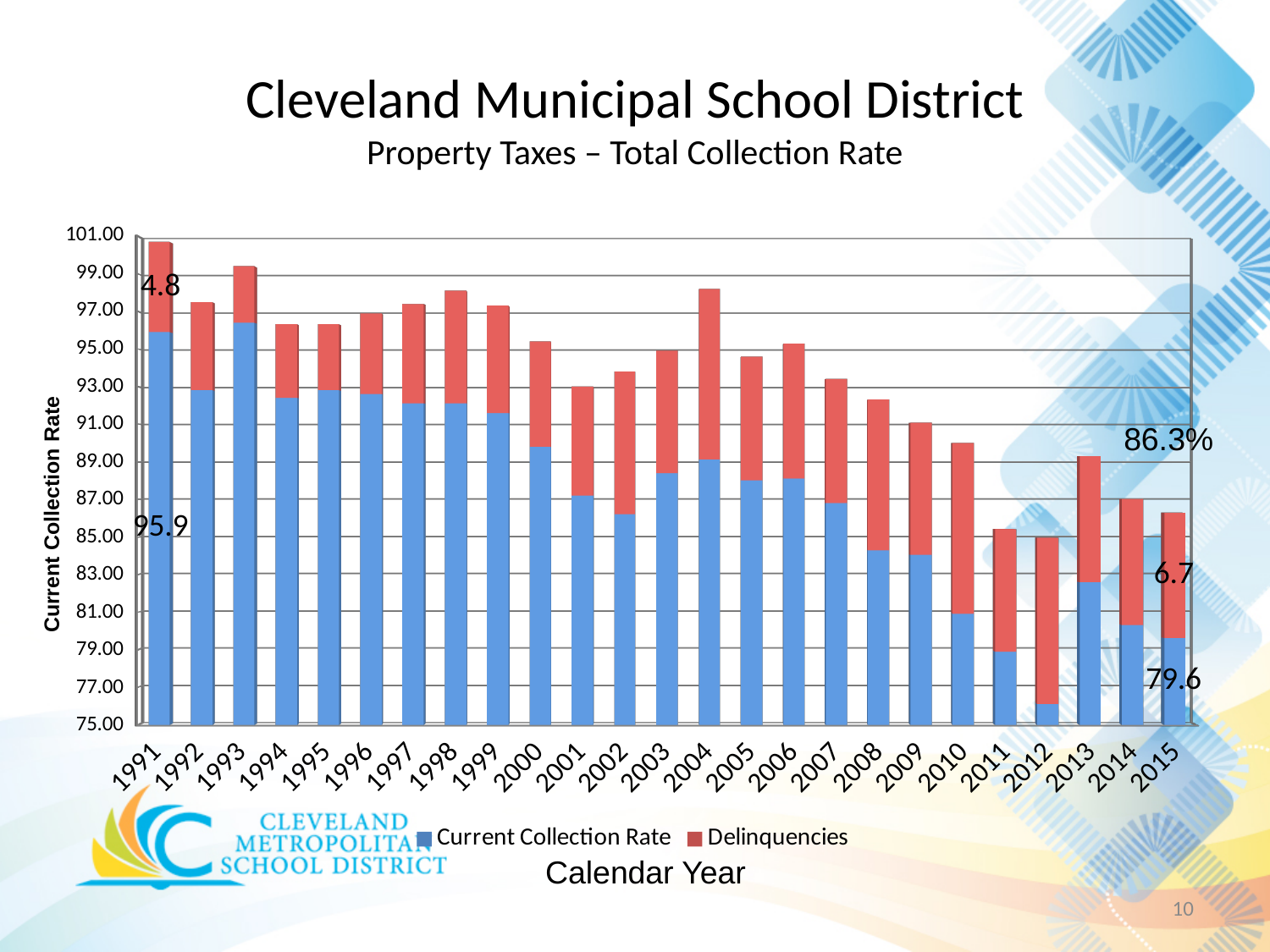
What is the Current Collection Rate for 2015? 79.6 How many calendar years are plotted on the x axis? 25 What is the difference between the Current Collection Rate in 1991 and in 2015? 16.3 What is the total collection rate (stacked bar total) for 2015? 86.3% What is the title of the x axis? Calendar Year What is the Delinquencies value for 2015? 6.7 How many series does the legend list? 2 Which year has the lowest Current Collection Rate? 2012 Is the Current Collection Rate for 2012 greater or less than 77.00? less What is the Delinquencies value for 1991? 4.8 What is the Current Collection Rate for 1991? 95.9 What type of chart is shown on the slide? Stacked bar chart